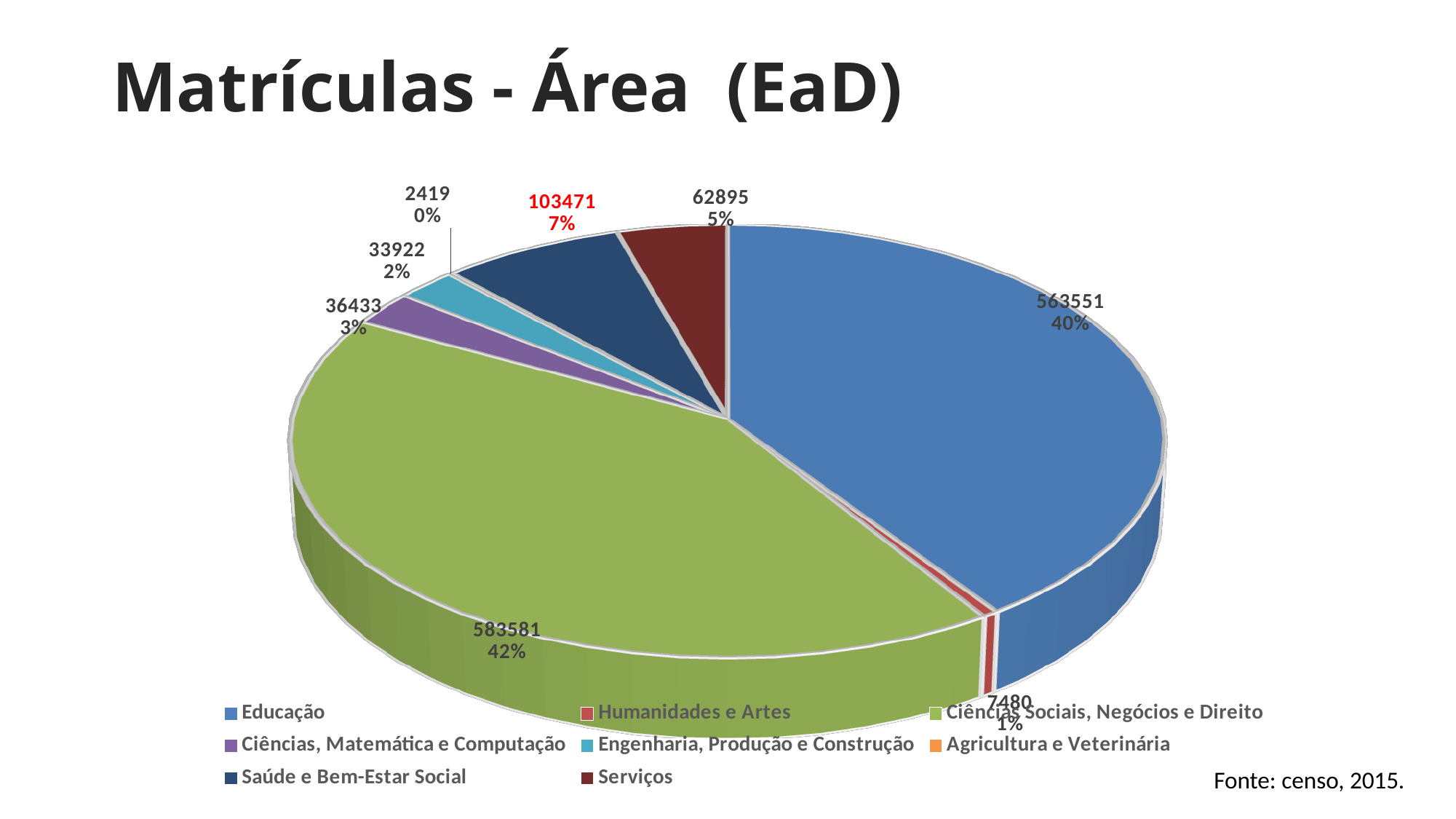
Which category has the largest slice of the pie? Ciências Sociais, Negócios e Direito How many categories does the legend list? 8 What is the number of enrolments for Educação? 563551 What is the value shown for Serviços? 62895 What is the difference between the values for Ciências Sociais, Negócios e Direito and Educação? 20030 Which is larger, the value for Ciências, Matemática e Computação or the value for Engenharia, Produção e Construção? Ciências, Matemática e Computação What is the title of the chart? Matrículas - Área (EaD) What percentage share is shown for Humanidades e Artes? 1% What percentage share of the pie does Ciências Sociais, Negócios e Direito have? 42% What is the value shown for Saúde e Bem-Estar Social? 103471 Which category has the smallest slice of the pie? Agricultura e Veterinária What type of chart is shown on the slide? pie chart